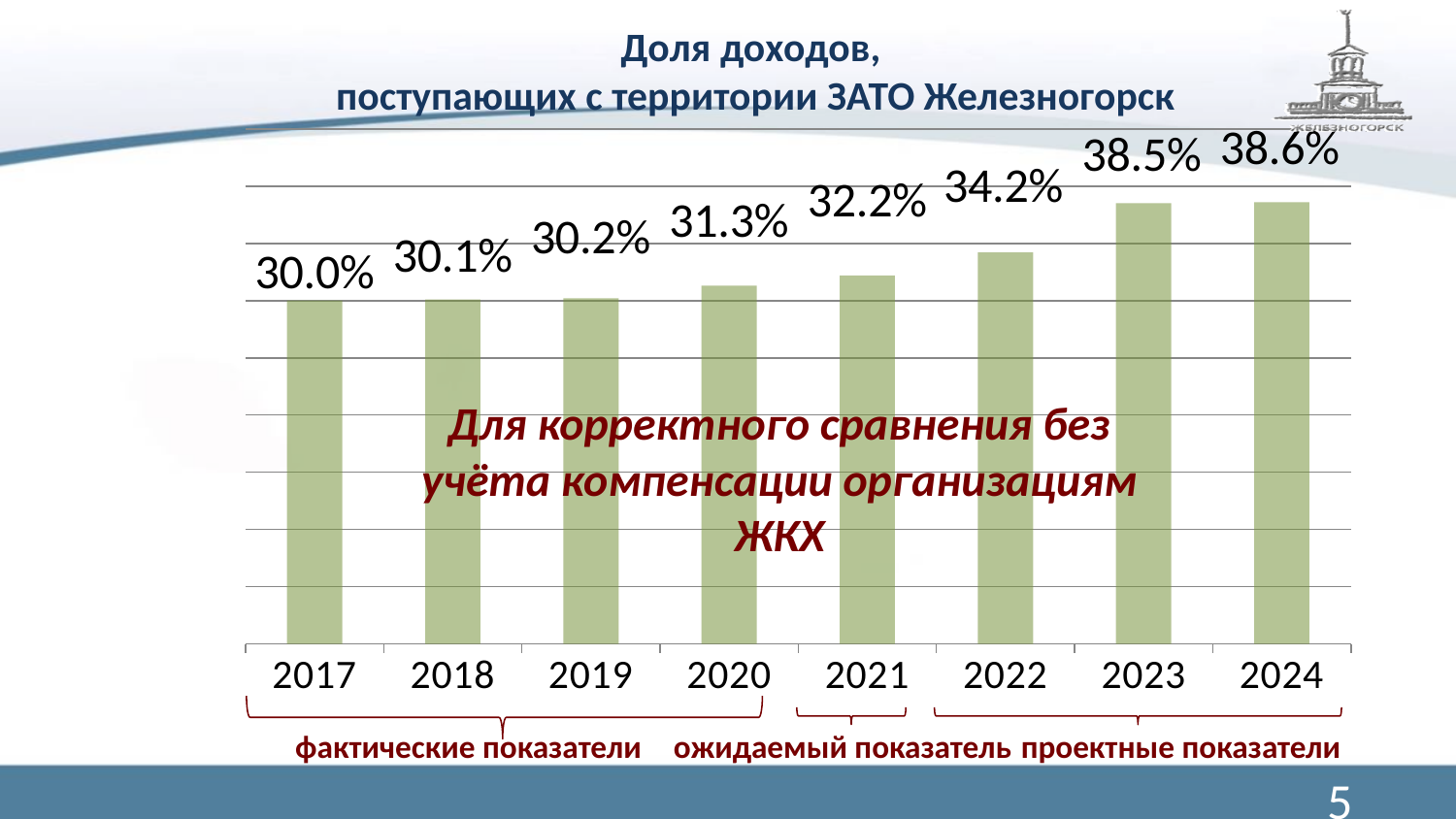
What is the difference between the values for 2023 and 2022? 4.3% How many years are shown on the x axis? 8 Which year has the lowest value? 2017 Which year has the highest value? 2024 What is the difference between the values for 2024 and 2017? 8.6% What is the value for 2017? 30.0% What kind of chart is this? bar chart What is the value for 2020? 31.3% What is the value for 2022? 34.2% Do the values rise or fall from 2017 to 2024? rise Which is larger, the value for 2021 or the value for 2019? 2021 What is the value for 2024? 38.6%